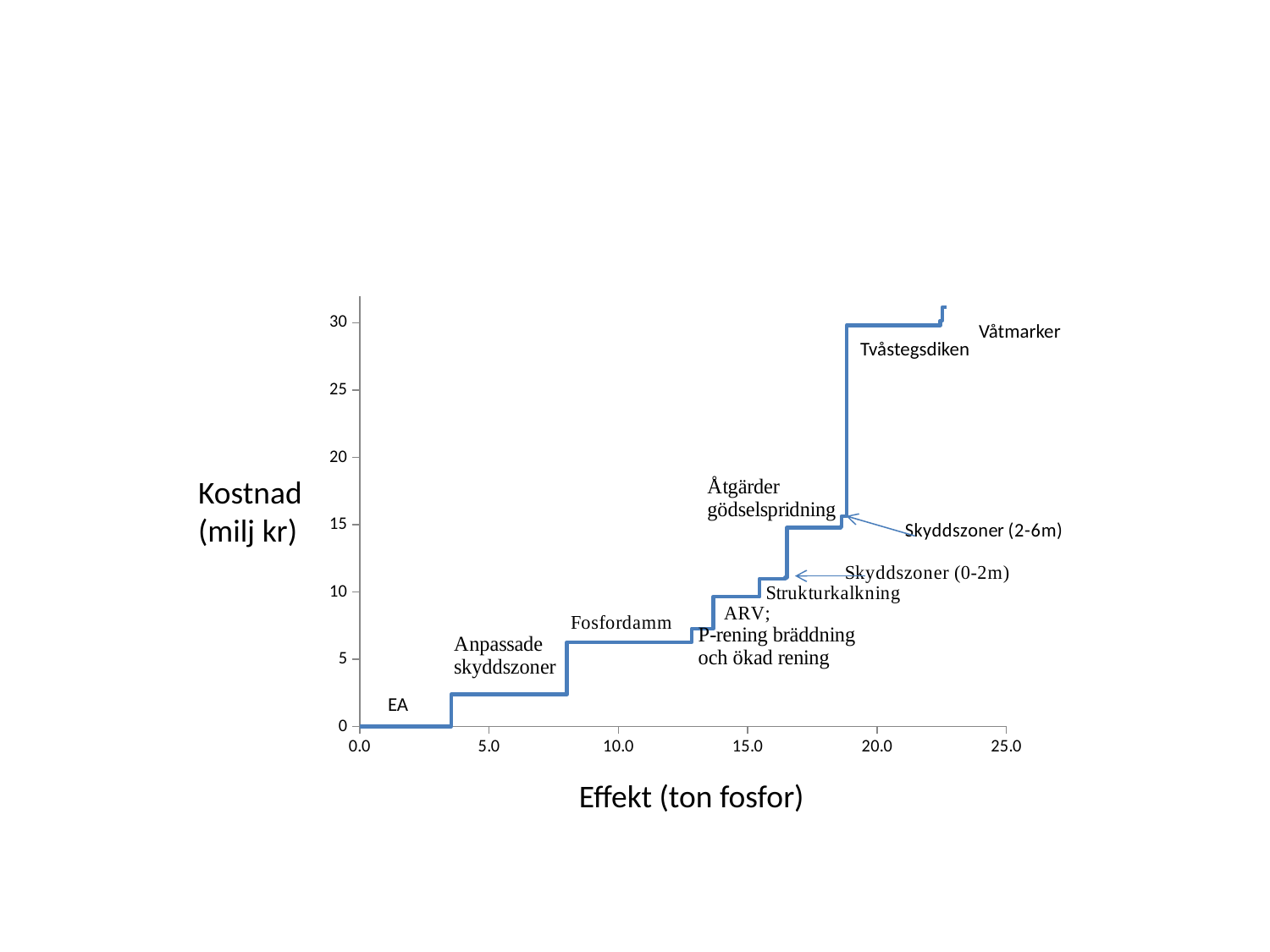
Is the cost level of the Tvåstegsdiken step greater or less than 25 milj kr? greater How many measures are labelled along the curve? 10 Is the cost level of the Strukturkalkning step greater or less than 15 milj kr? less Does the cost curve rise or fall as effect (ton fosfor) increases along the x axis? rise What is the label of the vertical axis? Kostnad (milj kr) Is the cost level of the Fosfordamm step greater or less than 10 milj kr? less What kind of chart is shown on the slide? line chart Which labelled measure has the lowest cost level on the curve? EA What is the label of the horizontal axis? Effekt (ton fosfor) Which labelled measure has the highest cost level on the curve? Våtmarker